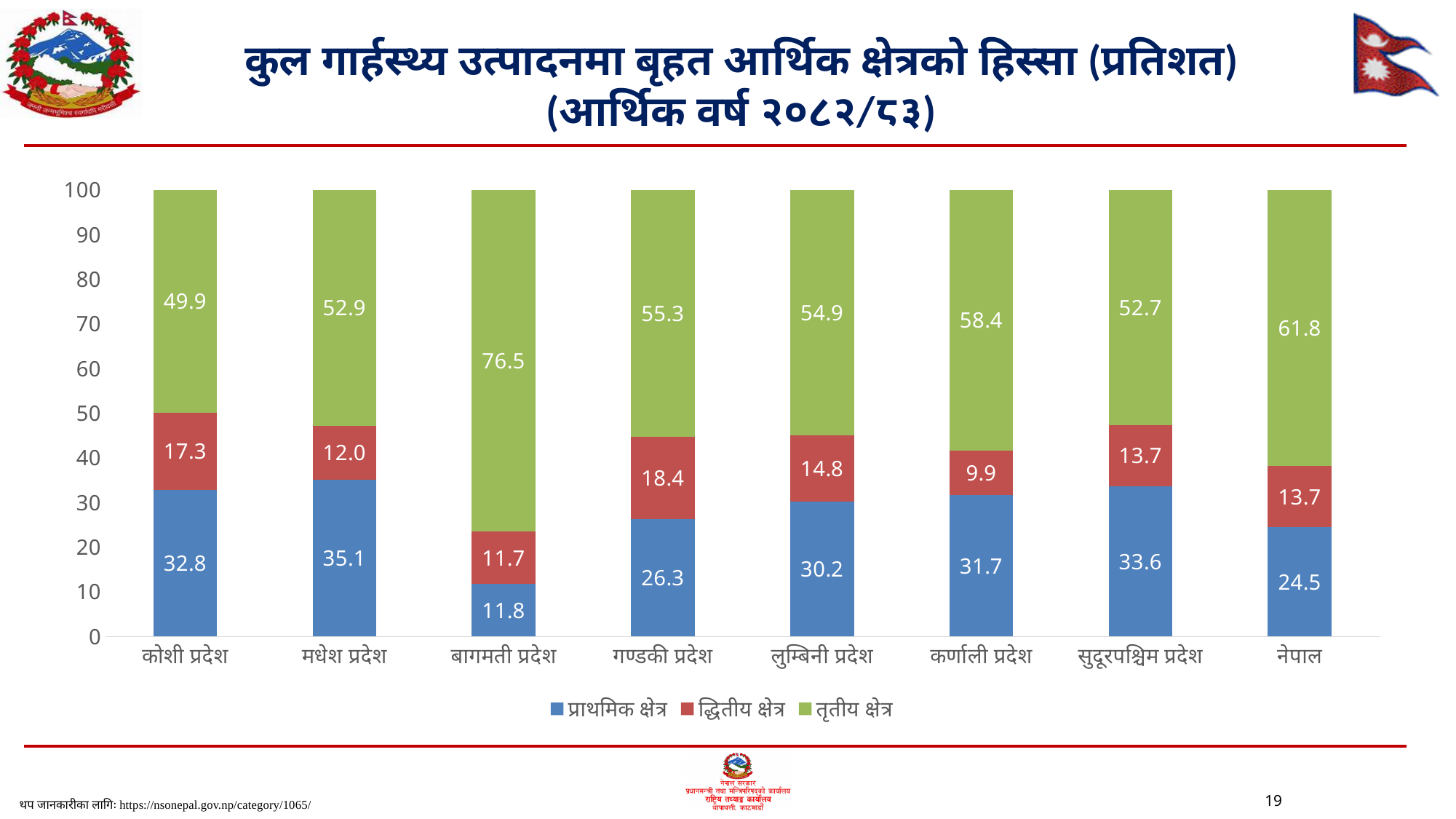
What is the value of तृतीय क्षेत्र for बागमती प्रदेश? 76.5 Which category has the lowest value for प्राथमिक क्षेत्र? बागमती प्रदेश What type of chart is shown on the slide? stacked bar chart Which category has the highest value for तृतीय क्षेत्र? बागमती प्रदेश What is the difference between the प्राथमिक क्षेत्र values for मधेश प्रदेश and गण्डकी प्रदेश? 8.8 What is the value of द्वितीय क्षेत्र for कर्णाली प्रदेश? 9.9 What is the value of प्राथमिक क्षेत्र for नेपाल? 24.5 How many categories are shown on the x axis of the chart? 8 What is the total of the stacked bar for कोशी प्रदेश? 100 How many series does the legend list? 3 Which is larger: the तृतीय क्षेत्र value for कर्णाली प्रदेश or for सुदूरपश्चिम प्रदेश? कर्णाली प्रदेश Which category has the highest value for द्वितीय क्षेत्र? गण्डकी प्रदेश